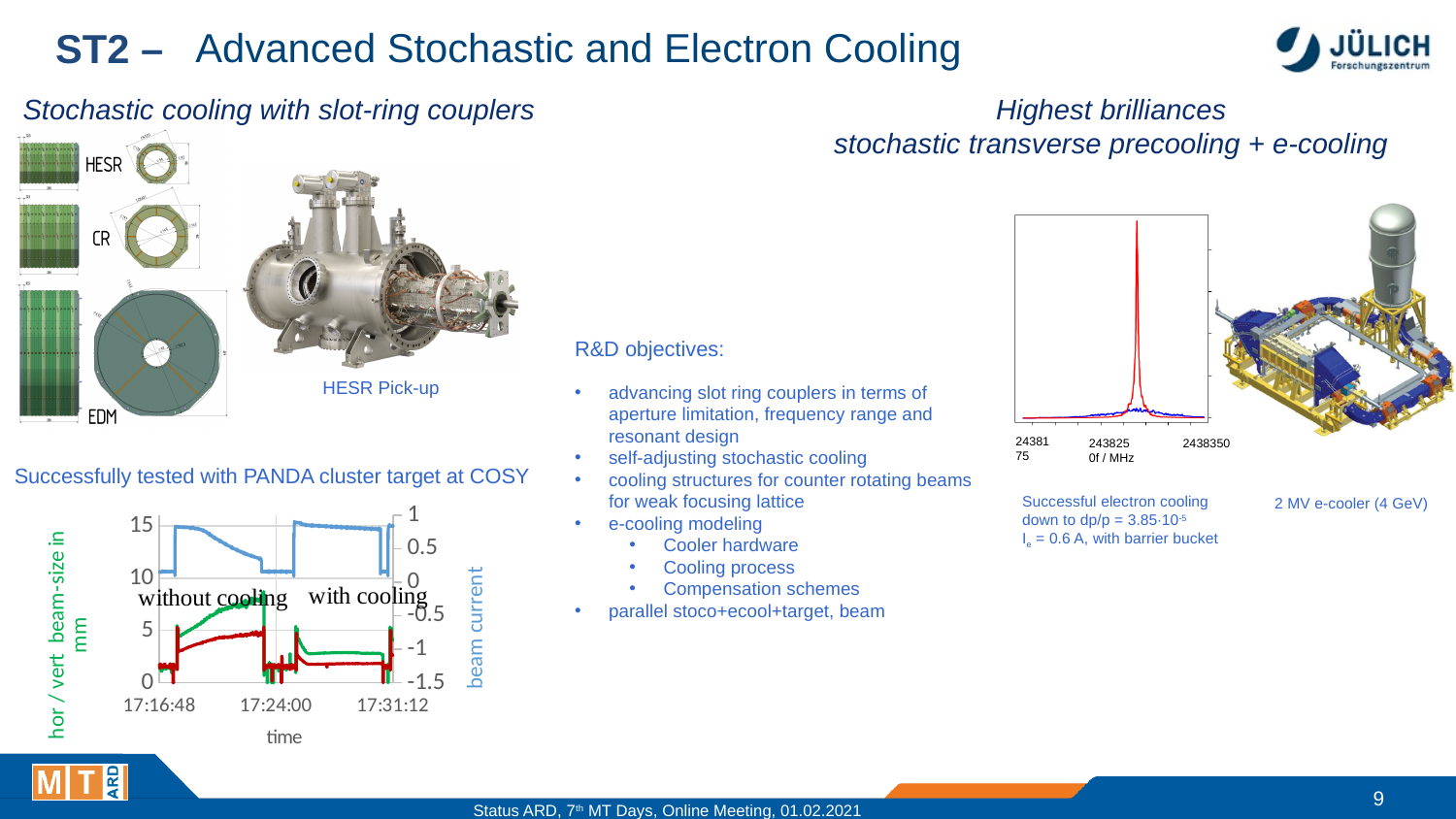
In the bottom-left chart, what is the label of the left y axis? hor / vert beam-size in mm In the bottom-left chart, what is the last time tick shown on the x axis? 17:31:12 In the bottom-left chart, what is the highest tick value on the left y axis? 15 In the bottom-left chart, what is the label of the x axis? time In the bottom-left chart, what is the first time tick shown on the x axis? 17:16:48 What kind of chart is the bottom-left chart with the time axis? line chart In the spectrum chart on the right, which colour line shows the tall sharp peak? red In the bottom-left chart, does the green line rise or fall during the period labelled 'without cooling'? rise In the bottom-left chart, what is the lowest tick value on the right y axis? -1.5 In the bottom-left chart, is the green line higher or lower during 'with cooling' than during 'without cooling'? lower How many lines are plotted in the bottom-left chart? 3